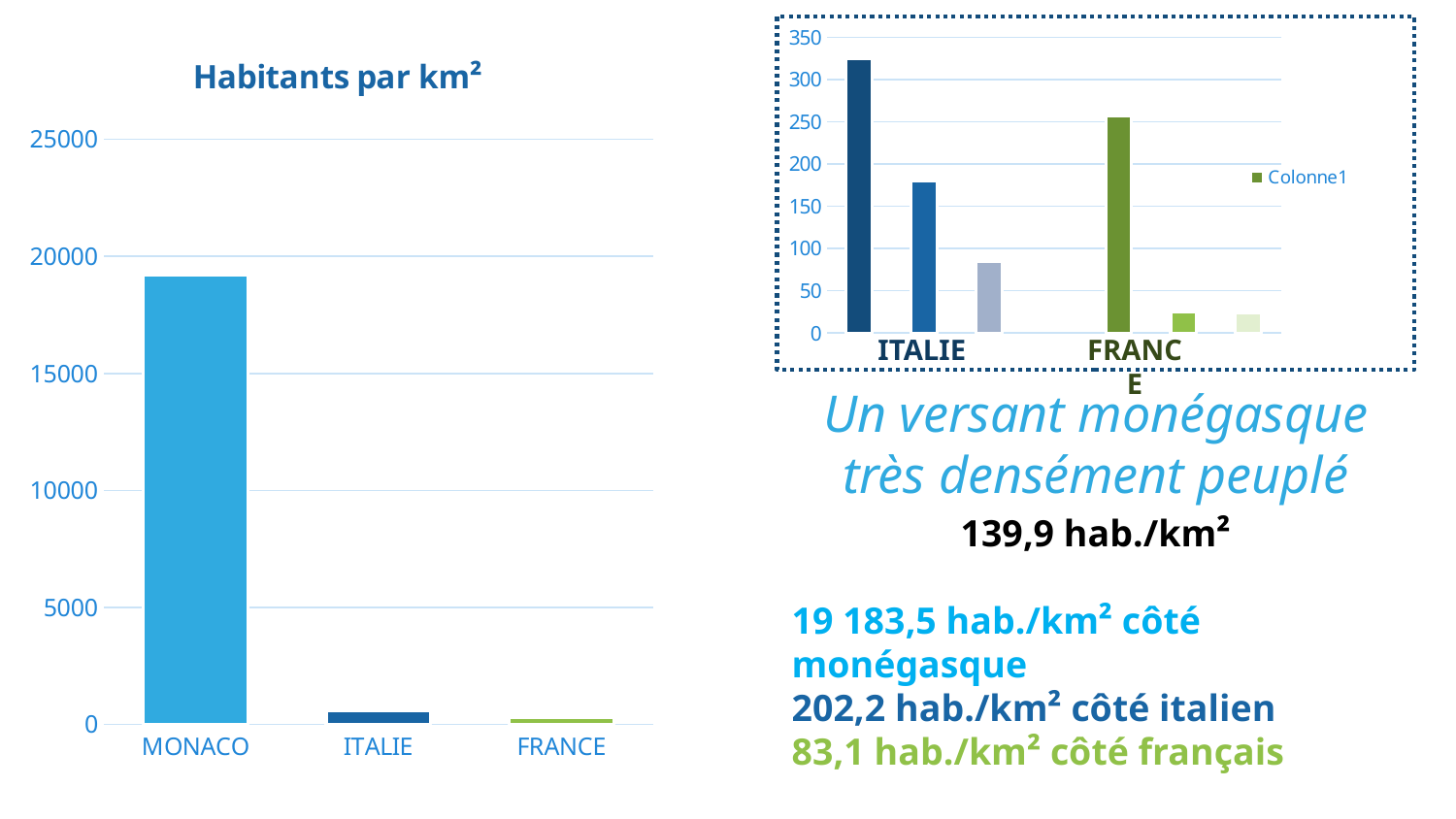
On the left chart titled 'Habitants par km²', what is the title of the chart? Habitants par km² On the right chart (top right, with ITALIE and FRANCE), is the tallest bar for ITALIE greater or less than 300? greater On the left chart titled 'Habitants par km²', is the value for MONACO greater or less than 15000? greater On the right chart (top right, with ITALIE and FRANCE), what entry does the legend list? Colonne1 On the left chart titled 'Habitants par km²', which is larger, the value for ITALIE or the value for FRANCE? ITALIE On the left chart titled 'Habitants par km²', which category has the highest value? MONACO On the left chart titled 'Habitants par km²', what kind of chart is it? bar chart On the left chart titled 'Habitants par km²', which category has the lowest value? FRANCE On the left chart titled 'Habitants par km²', is the value for ITALIE greater or less than 5000? less On the right chart (top right, with ITALIE and FRANCE), which category contains the tallest bar? ITALIE On the left chart titled 'Habitants par km²', how many categories are shown on the x axis? 3